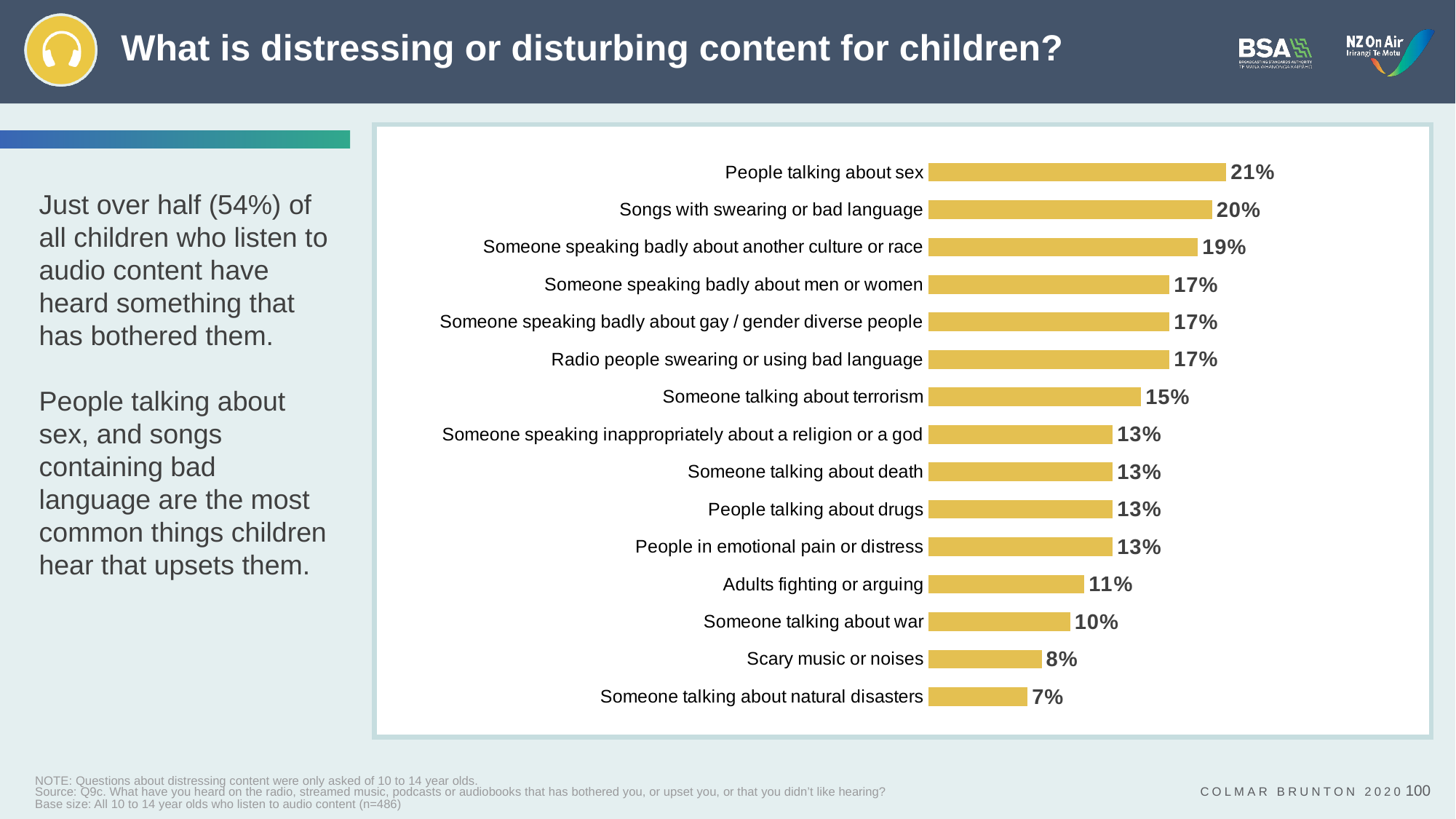
What kind of chart is shown on the slide? Bar chart What percentage of children said people talking about sex was distressing or disturbing content? 21% Which is larger: the value for 'Someone speaking badly about another culture or race' or the value for 'Adults fighting or arguing'? Someone speaking badly about another culture or race Which category has the lowest value in the chart? Someone talking about natural disasters What is the difference between the values for 'Songs with swearing or bad language' and 'Someone talking about war'? 10% What is the value for 'Someone talking about terrorism'? 15% What is the difference between the highest and lowest values in the chart? 14% What colour are the bars in the chart? Yellow What is the value for 'Scary music or noises'? 8% Which category has the highest value in the chart? People talking about sex How many categories are shown in the chart? 15 How many categories share the value 13%? 4